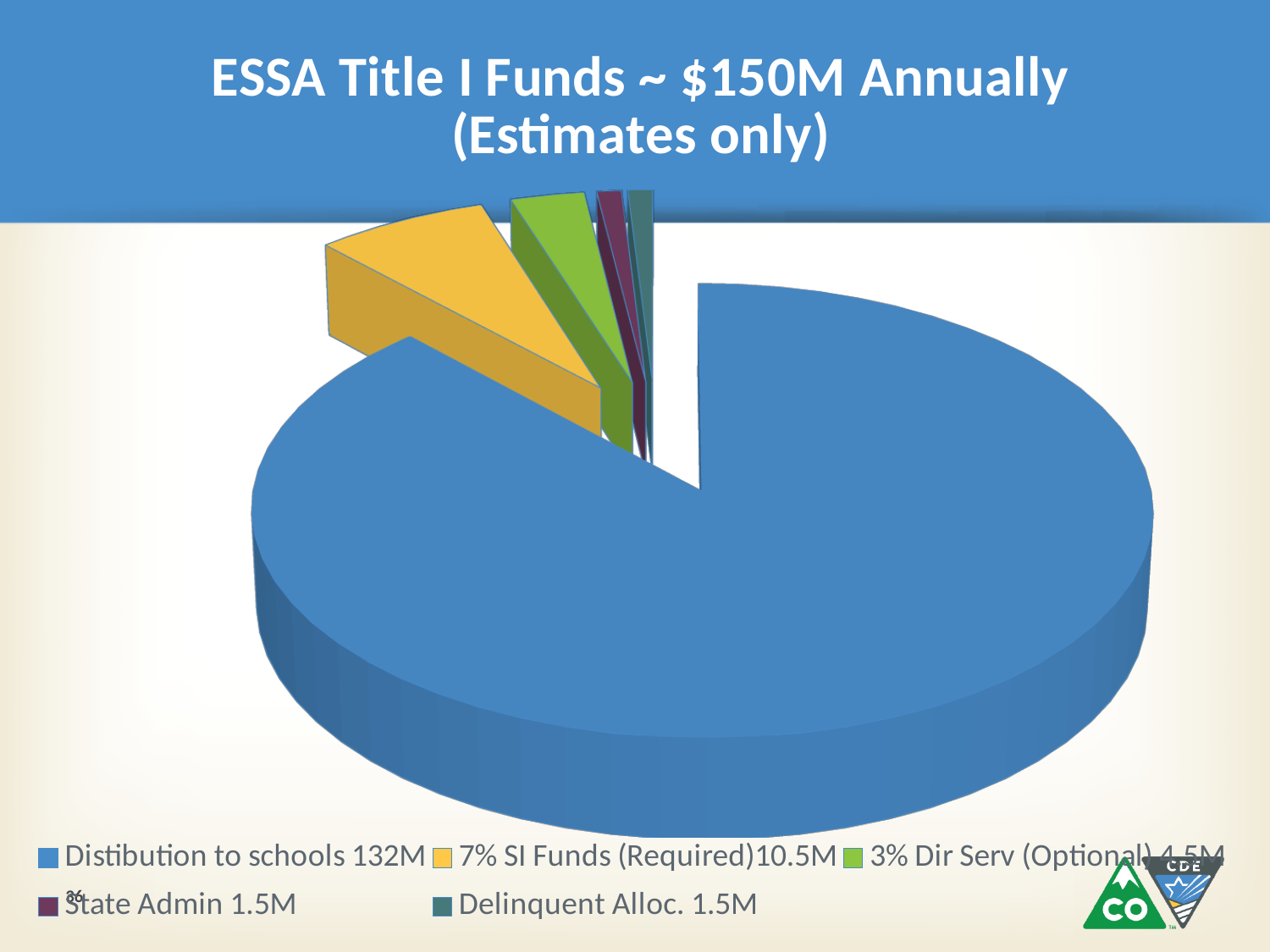
What is the difference between 7% SI Funds (Required) and State Admin? 9M What value is shown for Distibution to schools? 132M What is the difference between Distibution to schools and 7% SI Funds (Required)? 121.5M How many slices does the pie chart have? 5 What value is shown for Delinquent Alloc.? 1.5M What colour is the Distibution to schools slice? blue Which is larger, 7% SI Funds (Required) or 3% Dir Serv (Optional)? 7% SI Funds (Required) What kind of chart is shown on the slide? pie chart What is the title of the chart? ESSA Title I Funds ~ $150M Annually (Estimates only) What value is shown for State Admin? 1.5M What value is shown for 7% SI Funds (Required)? 10.5M Which category has the largest slice of the pie? Distibution to schools